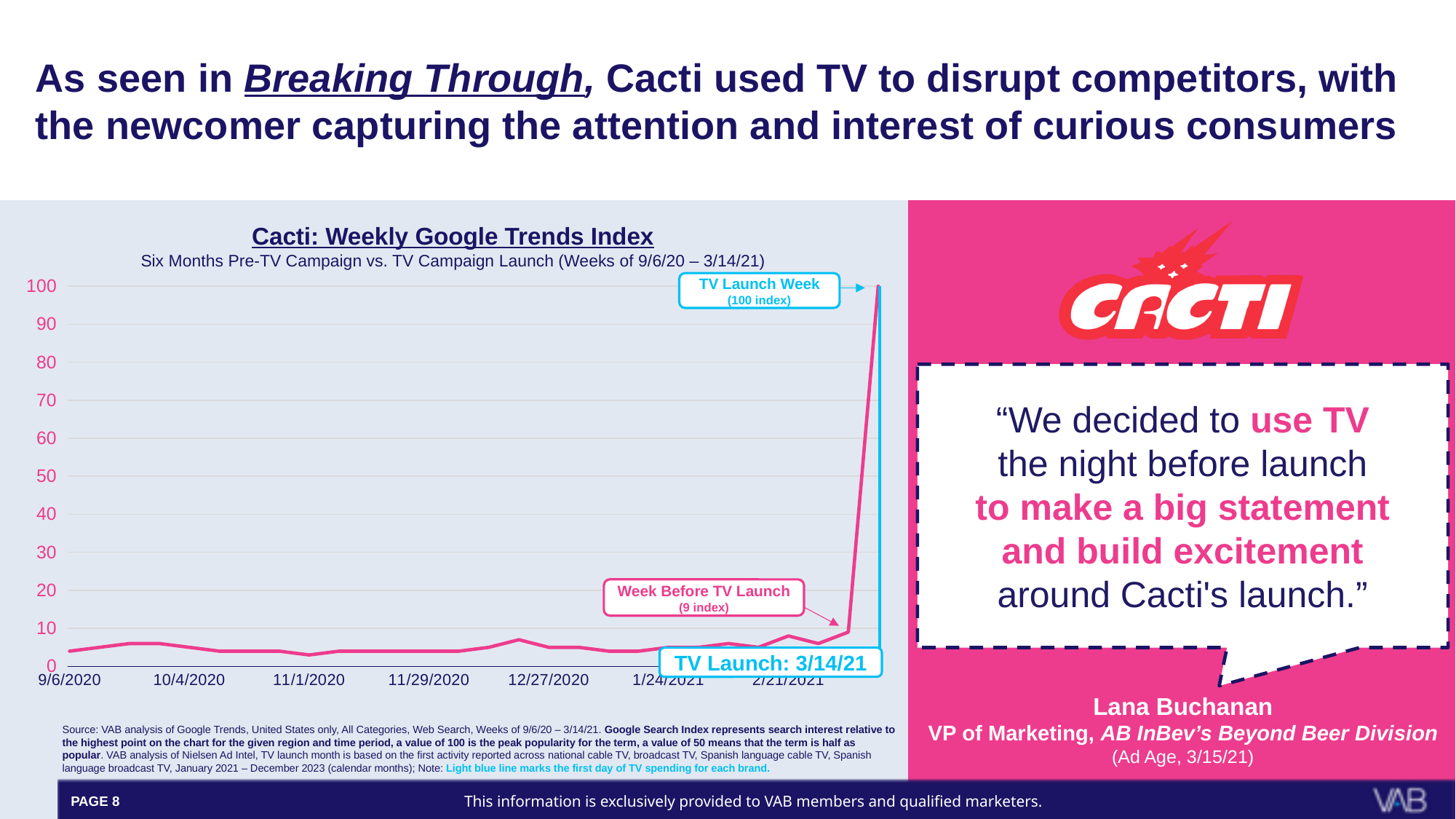
What is the title of the chart? Cacti: Weekly Google Trends Index Does the index rise or fall from the Week Before TV Launch to the TV Launch Week? rise What kind of chart is shown on the slide? line chart What is the Google Trends index value for the TV Launch Week? 100 How many date labels are shown on the x axis? 7 What is the difference between the index for the TV Launch Week and the Week Before TV Launch? 91 Is the index value for 12/27/2020 greater or less than 20? less Which week has the highest Google Trends index on the chart? TV Launch Week (3/14/21) Which is larger, the index for the TV Launch Week or the Week Before TV Launch? TV Launch Week What is the Google Trends index value for the Week Before TV Launch? 9 Is the index value for 9/6/2020 greater or less than 10? less What date is marked as the TV Launch on the chart? 3/14/21